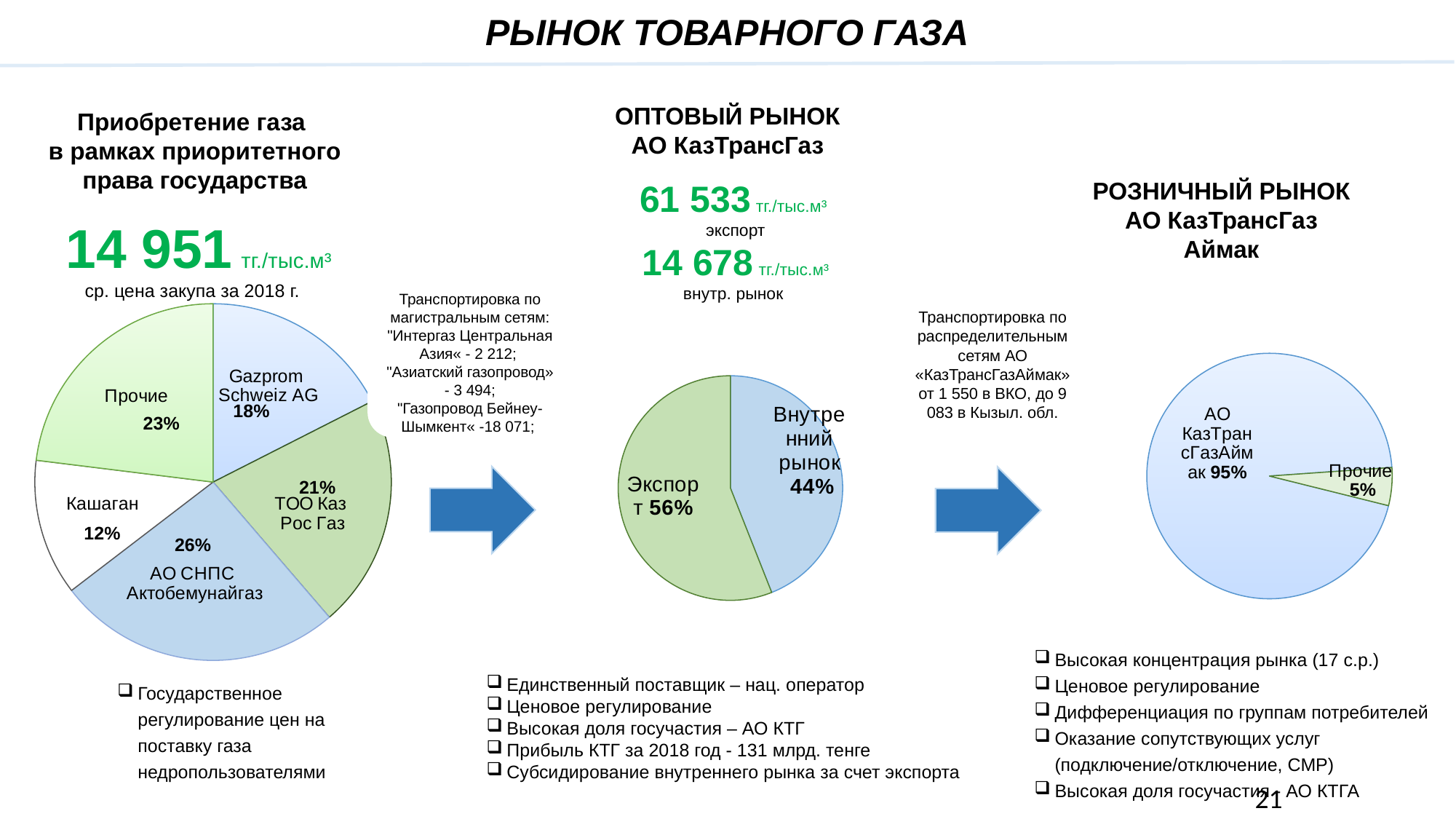
In the left pie chart, which category has the largest share? АО СНПС Актобемунайгаз In the left pie chart, which is larger: ТОО КазРосГаз or Gazprom Schweiz AG? ТОО КазРосГаз In the left pie chart, what share does Gazprom Schweiz AG hold? 18% In the left pie chart, what is the difference in percentage points between Прочие and Кашаган? 11 What type of chart is used for the Оптовый рынок АО КазТрансГаз data in the middle of the slide? Pie chart In the middle pie chart, what share is Внутренний рынок? 44% In the middle pie chart (Оптовый рынок АО КазТрансГаз), what share is Экспорт? 56% In the right pie chart, what share is Прочие? 5% In the left pie chart, how many slices are there? 5 In the left pie chart (Приобретение газа в рамках приоритетного права государства), what share does АО СНПС Актобемунайгаз hold? 26% In the right pie chart (Розничный рынок АО КазТрансГаз Аймак), what share does АО КазТрансГазАймак hold? 95% In the left pie chart, which category has the smallest share? Кашаган